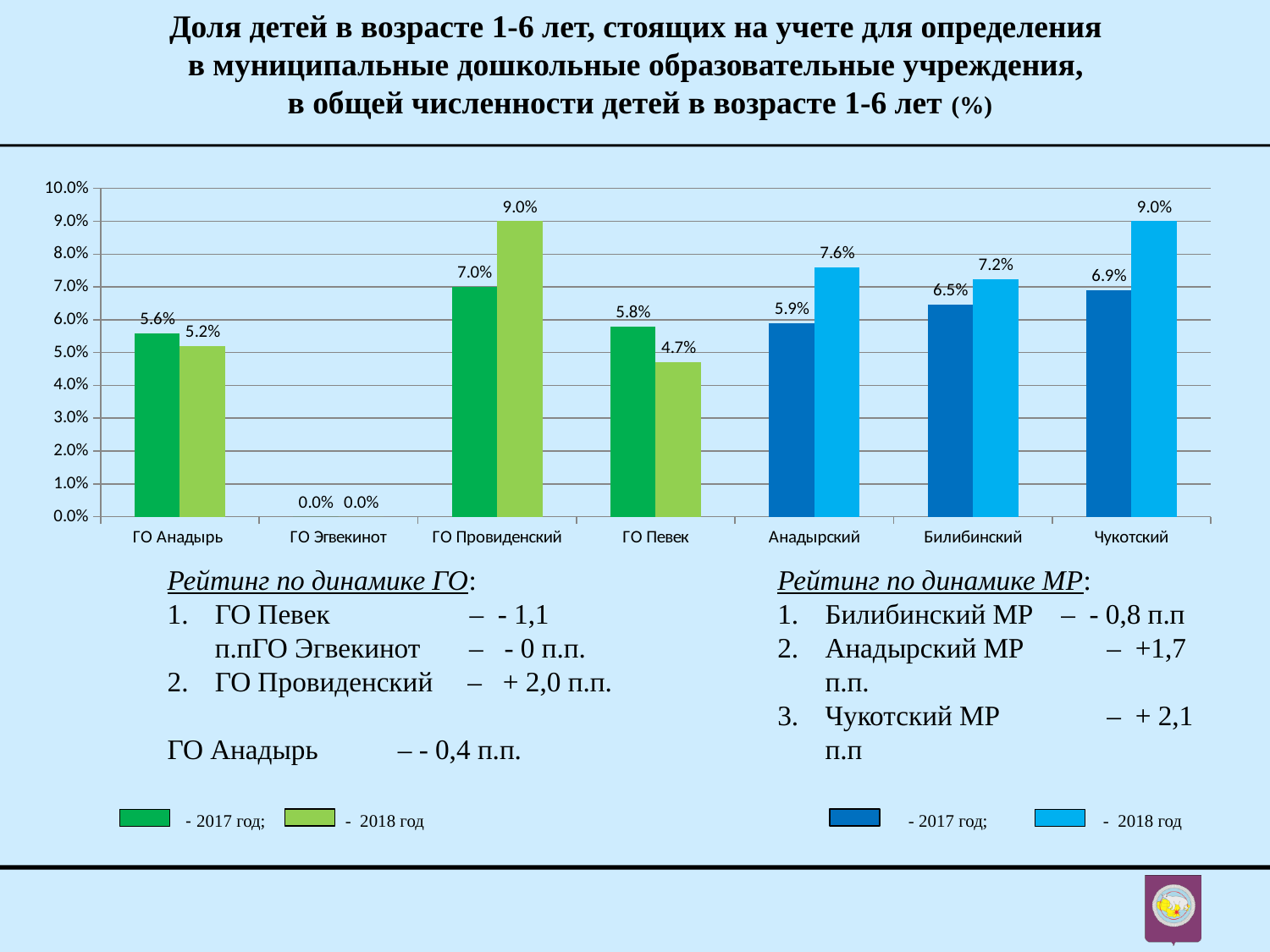
Which category has the highest 2017 value? ГО Провиденский What is the difference between the 2018 and 2017 values for Чукотский? 2.1% Which is larger for ГО Анадырь, the 2017 value or the 2018 value? 2017 Is the 2018 value for Билибинский greater or less than 7.0%? greater What is the 2018 value for Анадырский? 7.6% What colour are the 2018 bars for the МР categories (Анадырский, Билибинский, Чукотский)? light blue What is the 2017 value for ГО Провиденский? 7.0% What kind of chart is shown on the slide? bar chart What is the 2018 value for ГО Певек? 4.7% Which category has the lowest values in the chart? ГО Эгвекинот What is the 2017 value for Билибинский? 6.5% How many categories are shown on the x axis of the chart? 7